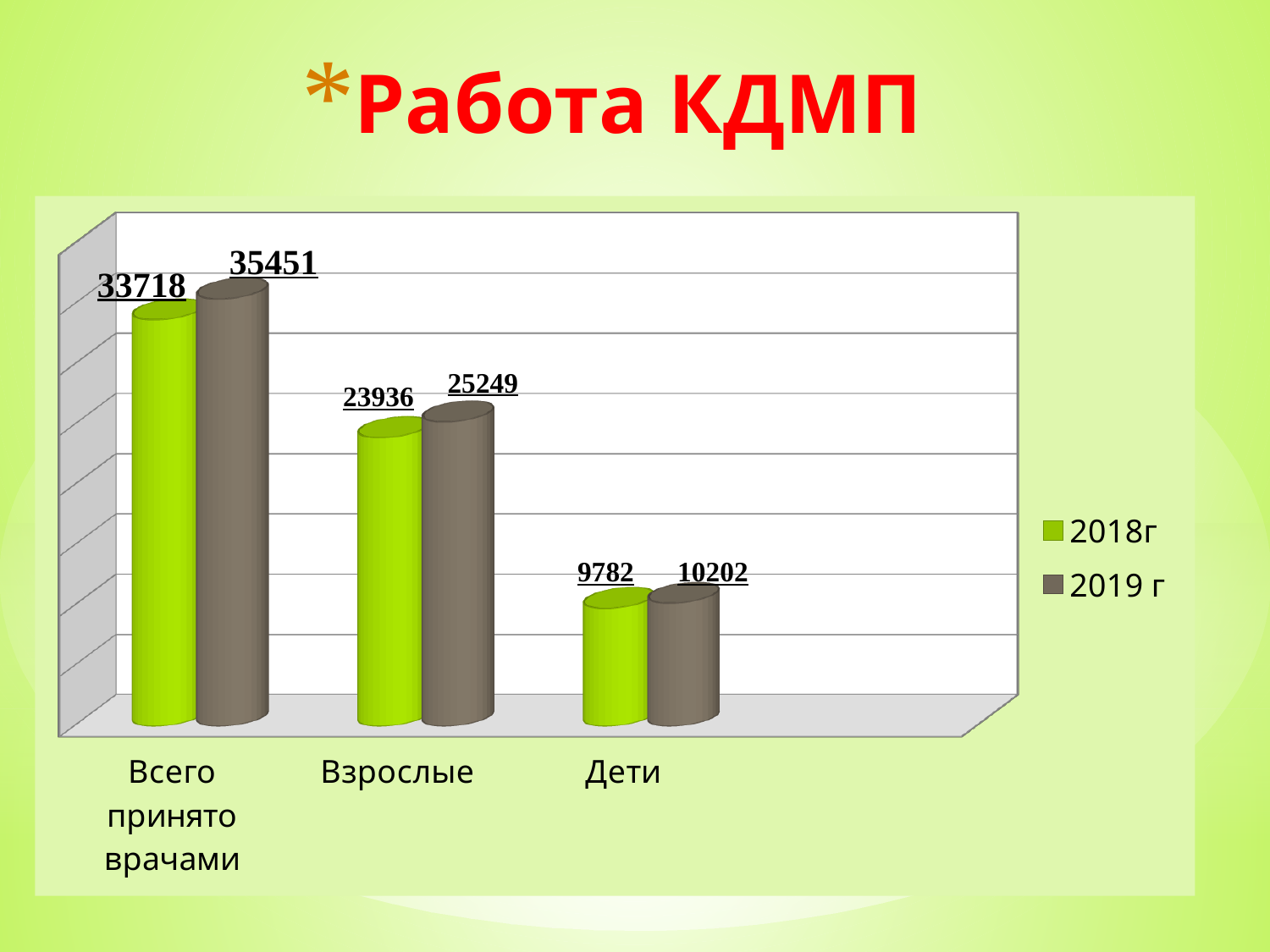
Which category has the highest value in the 2019 г series? Всего принято врачами How many categories are shown on the x axis? 3 Which category has the lowest value in the 2018г series? Дети What is the value for 'Взрослые' in the 2019 г series? 25249 What is the value for 'Всего принято врачами' in the 2018г series? 33718 What is the difference between the 2019 г and 2018г values for 'Взрослые'? 1313 How many series does the legend list? 2 What is the value for 'Дети' in the 2018г series? 9782 What kind of chart is shown on the slide? Bar chart What is the value for 'Дети' in the 2019 г series? 10202 What is the difference between the 2019 г and 2018г values for 'Всего принято врачами'? 1733 Which is larger for 'Дети': the 2018г value or the 2019 г value? 2019 г